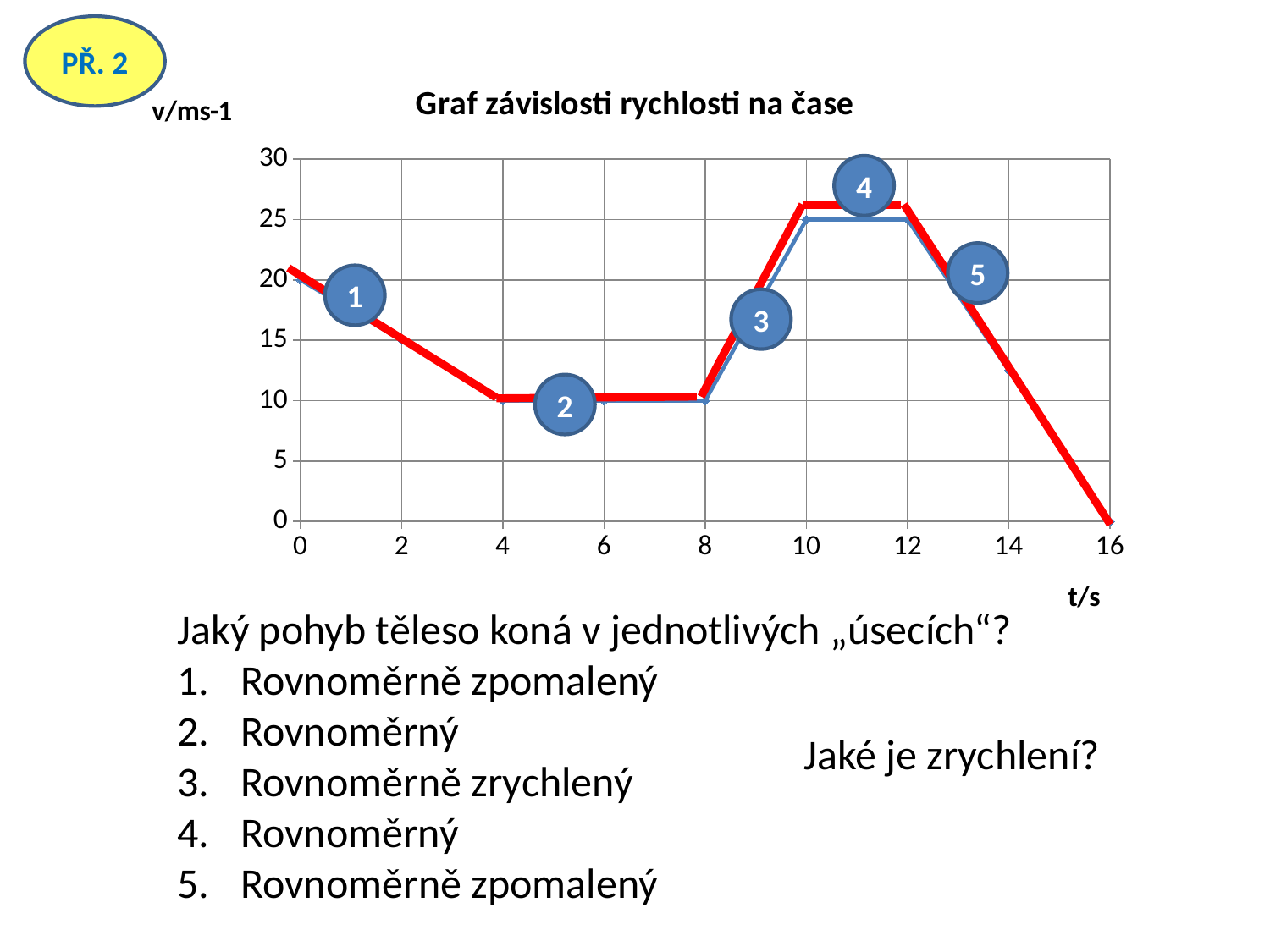
What is the velocity at t = 4 s? 10 What is the velocity at t = 16 s? 0 Which is larger, the velocity at t = 0 s or the velocity at t = 12 s? t = 12 s What is the difference between the velocity at t = 10 s and the velocity at t = 4 s? 15 What is the velocity at t = 10 s? 25 What kind of chart is shown on the slide? line chart At which time does the velocity reach its lowest value? 16 What is the highest velocity value reached on the chart? 25 What is the velocity at t = 0 s? 20 Does the velocity rise or fall between t = 12 s and t = 16 s? fall What is the title of the chart? Graf závislosti rychlosti na čase How many numbered segments are marked on the chart? 5